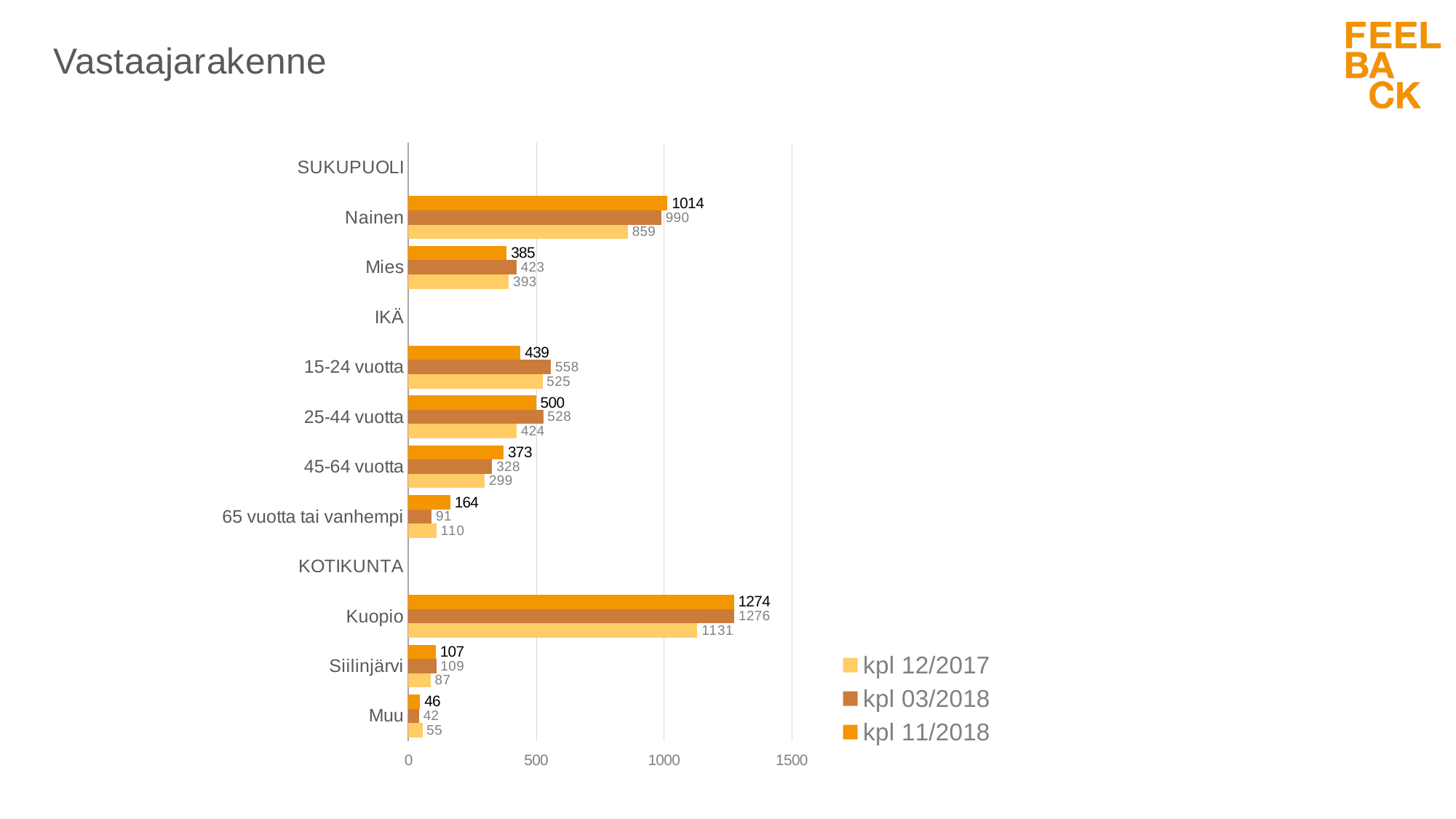
What is the value for Kuopio in the kpl 12/2017 series? 1131 Which is larger for 25-44 vuotta: the kpl 03/2018 value or the kpl 12/2017 value? kpl 03/2018 Which category has the highest value in the kpl 11/2018 series? Kuopio What is the value for 15-24 vuotta in the kpl 03/2018 series? 558 What is the title of the slide? Vastaajarakenne What is the value for 65 vuotta tai vanhempi in the kpl 11/2018 series? 164 Is the kpl 11/2018 value for Mies greater or less than 500? less What is the difference between the kpl 11/2018 and kpl 12/2017 values for Nainen? 155 How many series does the legend list? 3 Which category has the lowest value in the kpl 03/2018 series? Muu What kind of chart is shown on the slide? Bar chart What is the value for Nainen in the kpl 11/2018 series? 1014